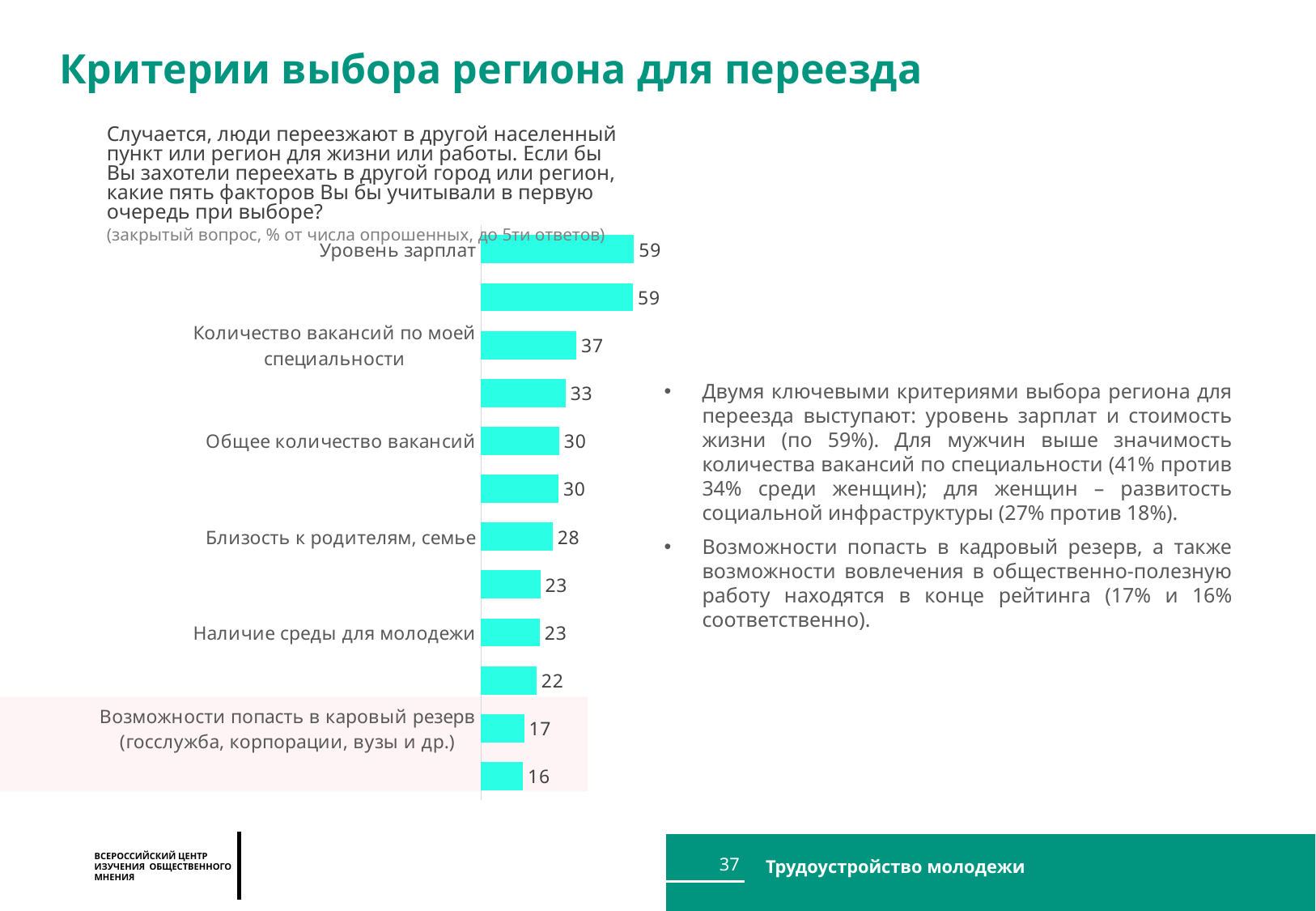
What is the value for «Близость к родителям, семье»? 28 What is the smallest value shown on the chart? 16 What is the difference between the values for «Уровень зарплат» and «Количество вакансий по моей специальности»? 22 How many bars are plotted on the chart? 12 What is the largest value shown on the chart? 59 What is the value for «Количество вакансий по моей специальности»? 37 Which is larger: the value for «Близость к родителям, семье» or for «Наличие среды для молодежи»? Близость к родителям, семье What is the value for «Возможности попасть в каровый резерв (госслужба, корпорации, вузы и др.)»? 17 What kind of chart is shown on the slide? Bar chart What is the value for «Уровень зарплат»? 59 What is the value for «Наличие среды для молодежи»? 23 What is the value for «Общее количество вакансий»? 30